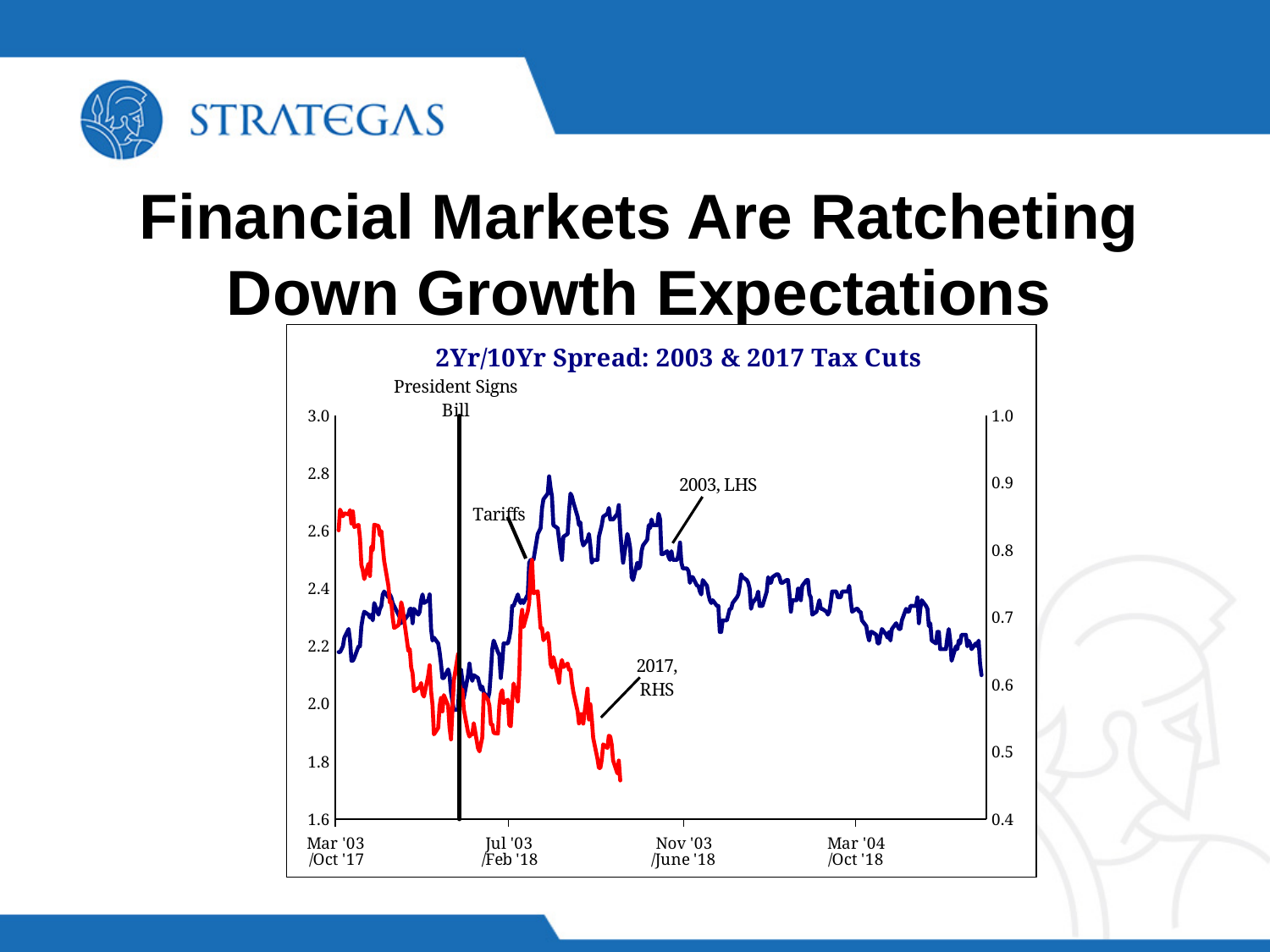
What kind of chart is shown on the slide? Line chart How many series are plotted on the chart? 2 Which series is plotted against the right-hand axis (RHS)? 2017 What is the highest value shown on the left-hand axis? 3.0 What is the lowest value shown on the right-hand axis? 0.4 Is the starting value of the 2017 series (right axis) at Oct '17 greater or less than 0.8? greater Is the peak value of the 2003 series (left axis) greater or less than 2.6? greater Does the 2017 series rise or fall overall from Oct '17 to June '18? Fall How many date labels are shown along the x axis? 4 Is the final value of the 2017 series (right axis) at the end of its line greater or less than 0.5? less What is the title of the chart? 2Yr/10Yr Spread: 2003 & 2017 Tax Cuts